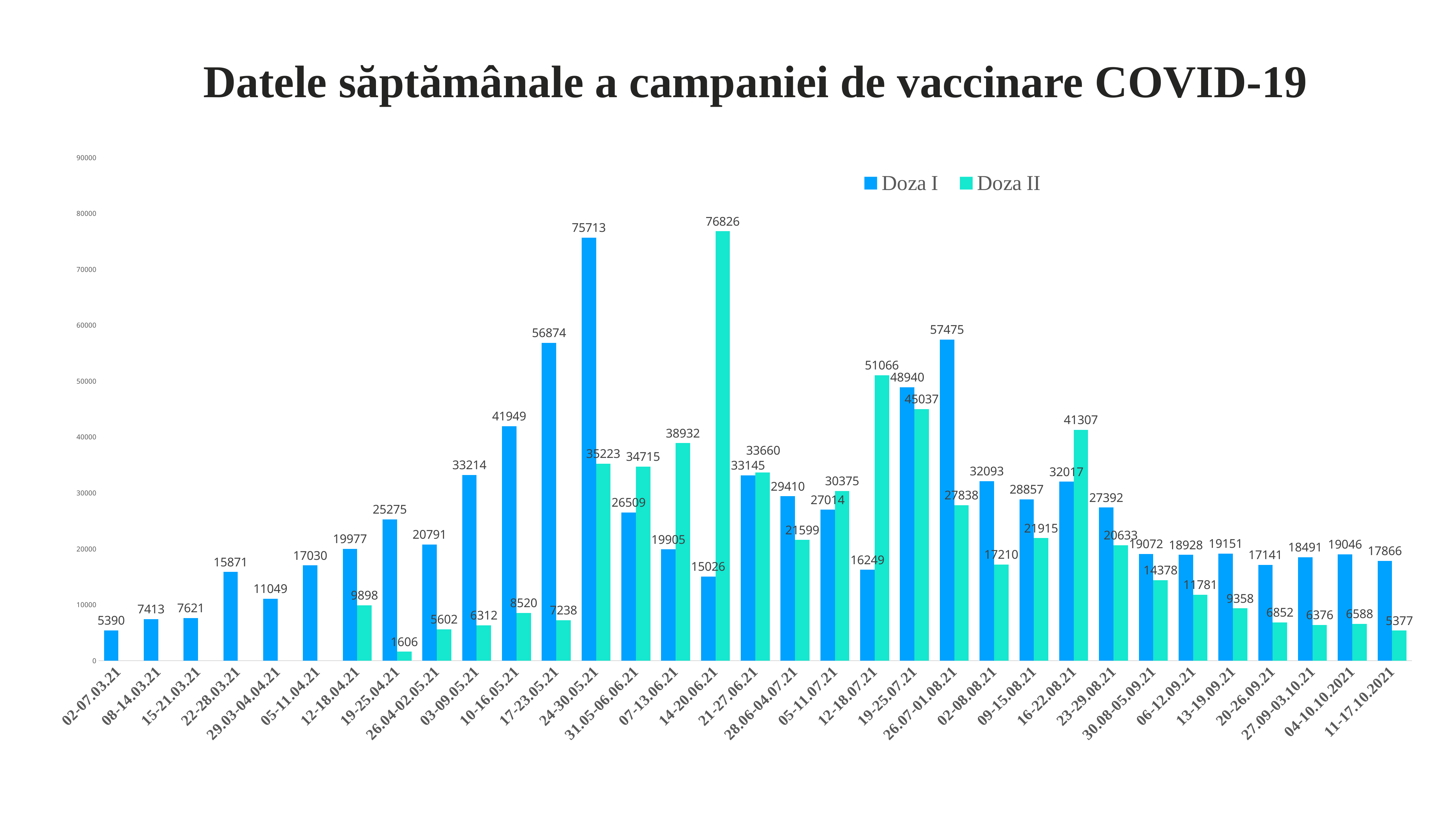
What is the Doza I value for the week 24-30.05.21? 75713 How many weeks (categories) are shown on the x axis? 33 Which week has the highest Doza I value? 24-30.05.21 In the week 16-22.08.21, which is larger, Doza I or Doza II? Doza II What is the Doza II value for the week 14-20.06.21? 76826 What is the Doza II value for the week 12-18.07.21? 51066 Which week has the lowest Doza II value? 19-25.04.21 Which week has the lowest Doza I value? 02-07.03.21 Which week has the highest Doza II value? 14-20.06.21 How many series does the legend list? 2 What kind of chart is shown on the slide? Bar chart What is the difference between Doza I and Doza II in the week 19-25.07.21? 3903